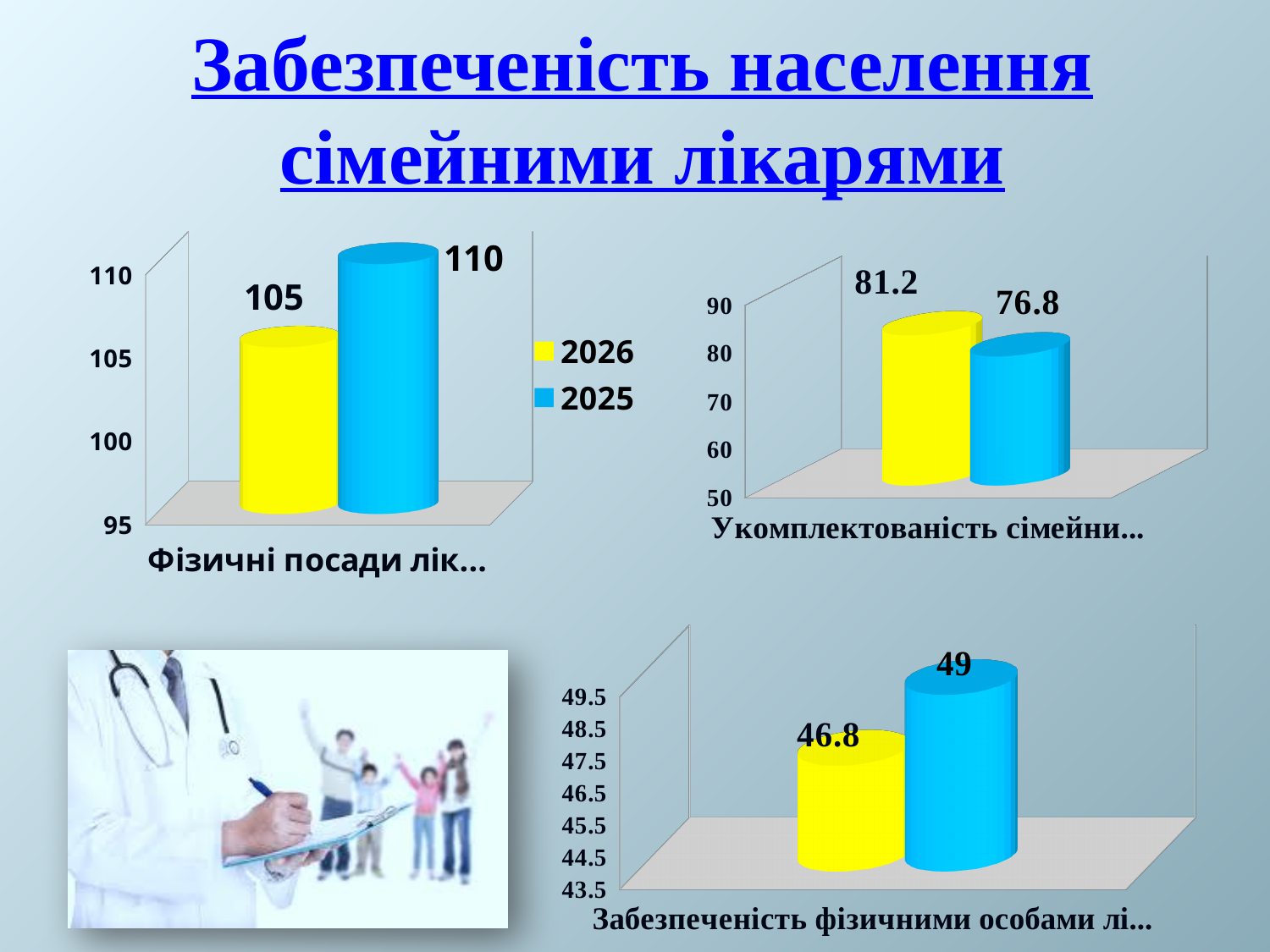
In the top-right chart, what is the value of the blue bar? 76.8 What kind of chart is the top-right chart? bar chart In the top-left chart, what is the value for 2025? 110 In the bottom-right chart, what is the difference between the blue bar and the yellow bar? 2.2 How many series does the legend of the top-left chart list? 2 In the bottom-right chart, what is the value of the yellow bar? 46.8 In the top-left chart, what is the difference between the 2025 and 2026 values? 5 In the top-right chart, which bar is higher, the yellow one or the blue one? yellow In the top-left chart, what is the value for 2026? 105 In the top-left chart, which series has the higher value, 2026 or 2025? 2025 In the bottom-right chart, what is the value of the blue bar? 49 In the top-right chart, what is the value of the yellow bar? 81.2